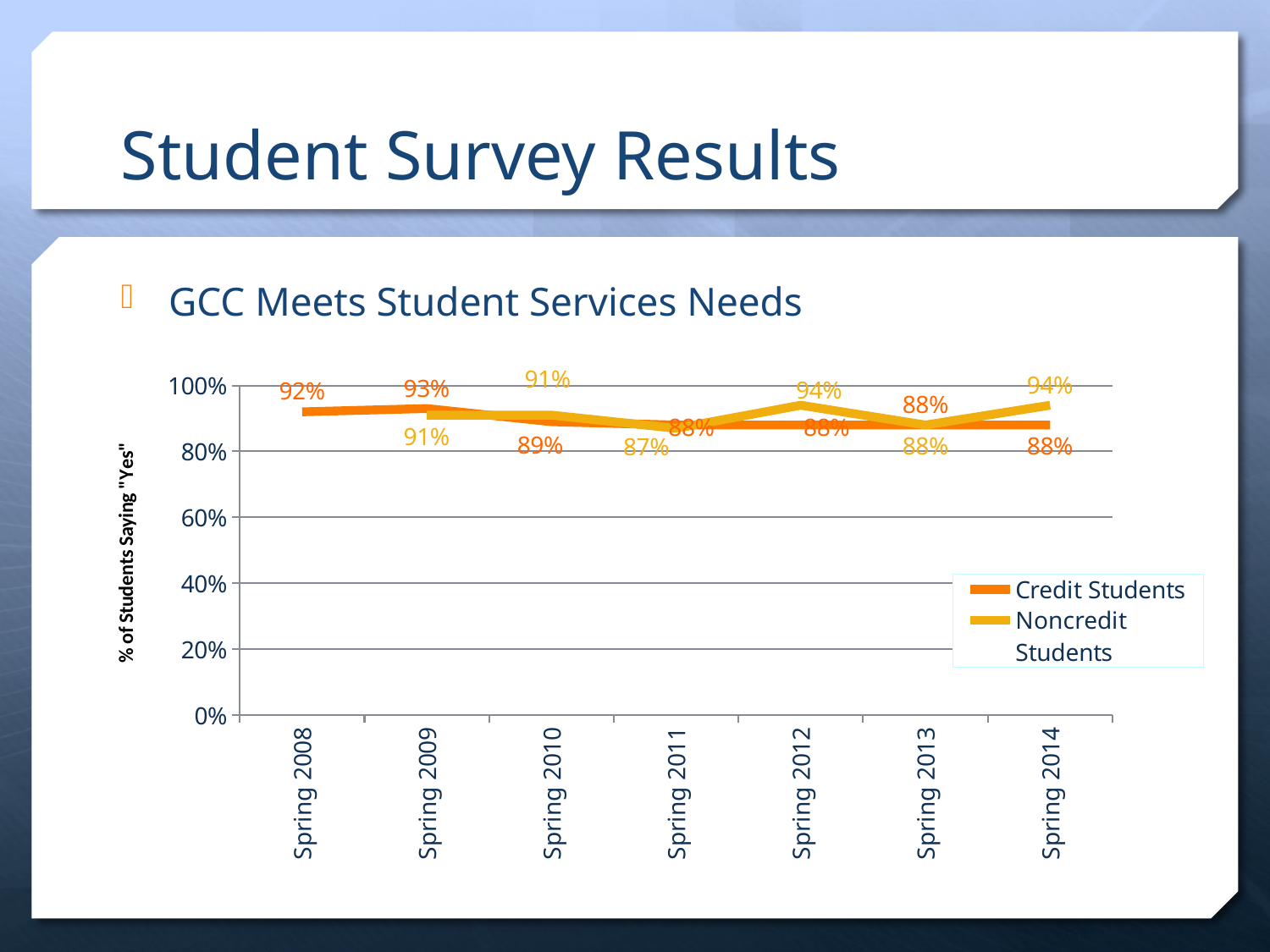
What is the title of the y axis? % of Students Saying "Yes" How many survey periods are shown on the x axis? 7 What is the value for Noncredit Students in Spring 2012? 94% What percentage of Credit Students said "Yes" in Spring 2008? 92% In which survey period was the Noncredit Students value lowest? Spring 2011 What is the value for Credit Students in Spring 2009? 93% In Spring 2012, how many percentage points higher is the Noncredit Students value than the Credit Students value? 6 percentage points In Spring 2010, which series has the higher value, Credit Students or Noncredit Students? Noncredit Students In which survey period was the Credit Students value highest? Spring 2009 What is the value for Noncredit Students in Spring 2011? 87% What kind of chart is shown on the slide? Line chart How many series does the legend list? 2